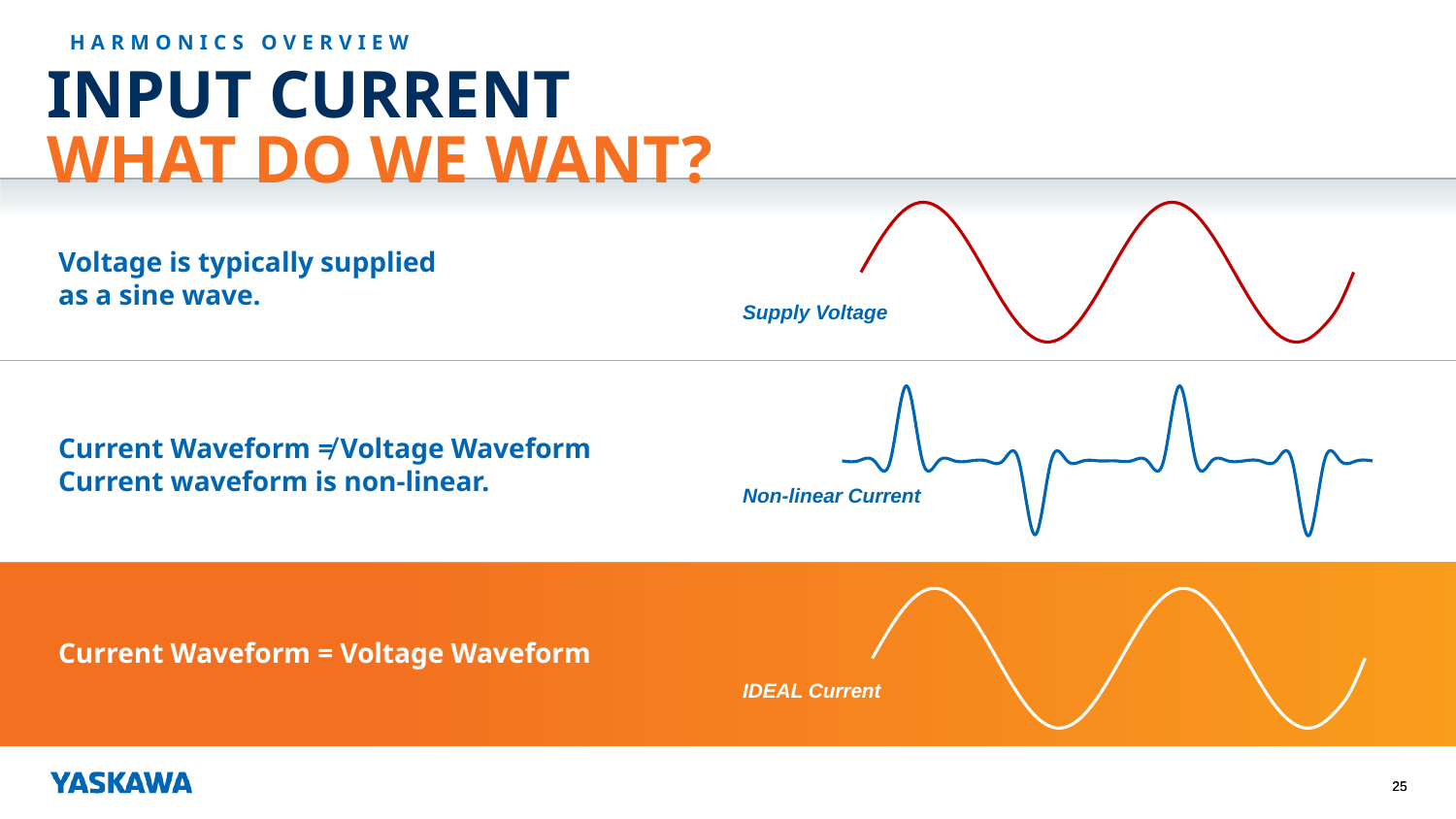
What is the label of the red waveform at the top of the slide? Supply Voltage What colour is the Non-linear Current waveform? blue What kind of chart is the Supply Voltage diagram? line chart What is the label of the white waveform on the orange band at the bottom of the slide? IDEAL Current How many waveform diagrams are shown on the slide? 3